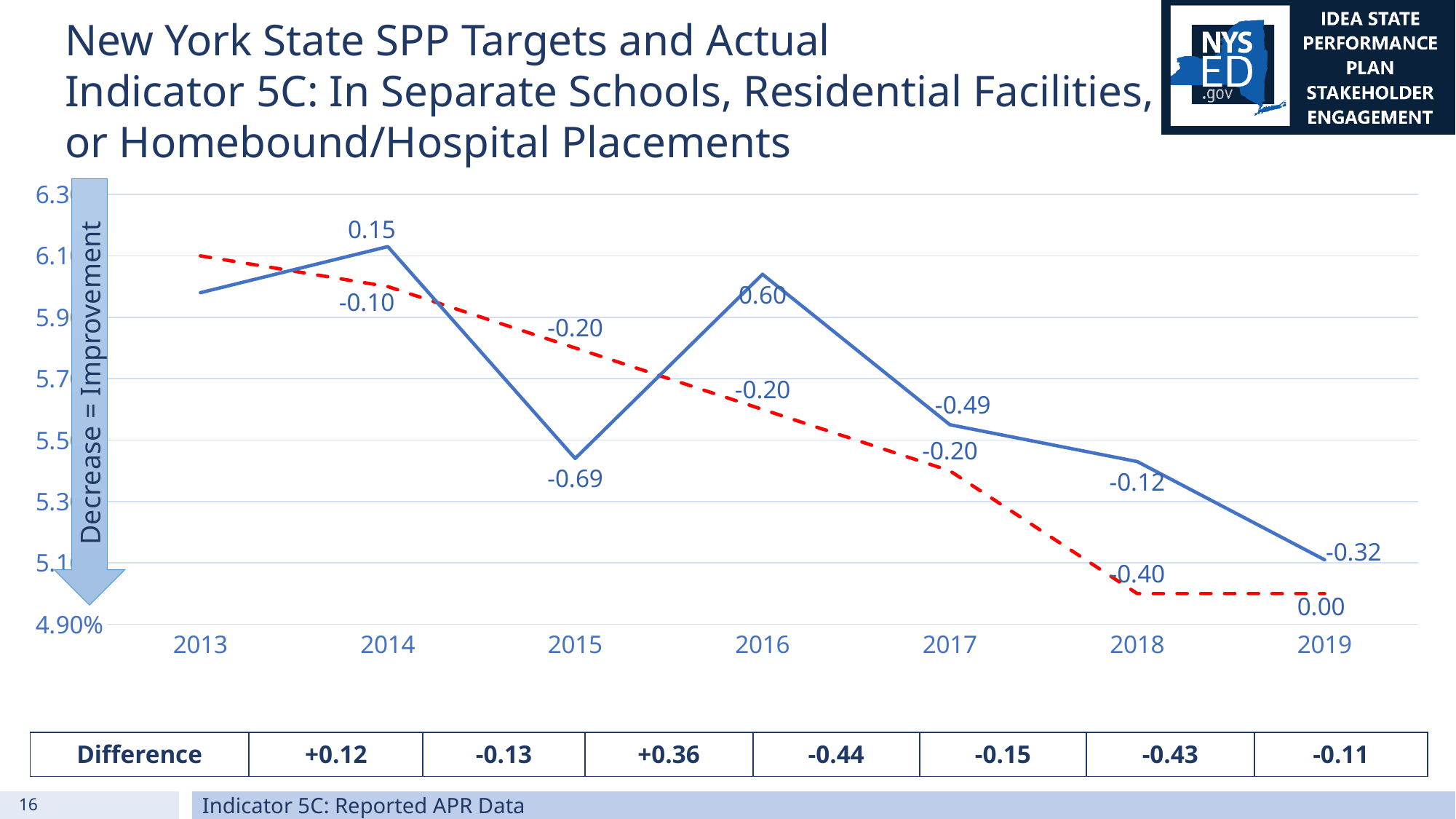
What data label is shown on the solid blue line at 2016? 0.60 What data label is shown on the solid blue line at 2015? -0.69 What kind of chart is shown on the slide? line chart How many lines are plotted on the chart? 2 Is the value of the solid blue line in 2013 greater or less than 6.1? less In which year does the solid blue line reach its lowest point? 2019 In 2016, is the solid blue line above or below the red dashed line? above What is the Difference value shown in the table for 2017? -0.15 Does the red dashed line rise or fall from 2013 to 2019? fall Is the value of the red dashed line in 2018 greater or less than 5.1? less What data label is shown on the red dashed line at 2018? -0.40 How many years are shown along the x axis of the chart? 7